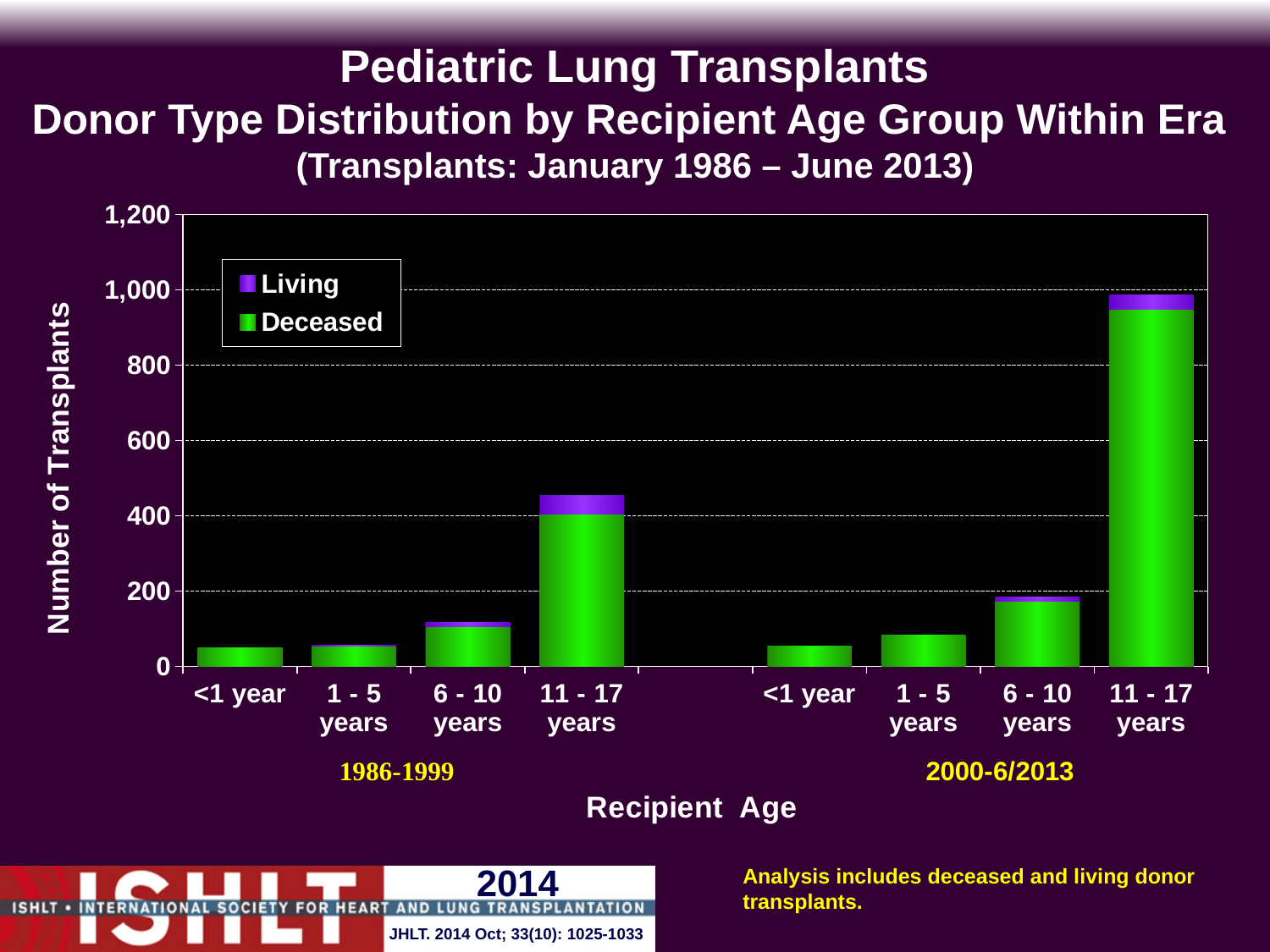
Which is larger: the total for 6 - 10 years in 1986-1999 or in 2000-6/2013? 2000-6/2013 Is the total for 11 - 17 years in the 1986-1999 era greater or less than 400? greater How many bars are plotted in the chart? 8 Which bar is the highest in the chart? 11 - 17 years, 2000-6/2013 Which is larger: the total for 11 - 17 years in 1986-1999 or in 2000-6/2013? 2000-6/2013 Within the 2000-6/2013 era, do the totals rise or fall as recipient age group increases? rise Is the total for 11 - 17 years in the 2000-6/2013 era greater or less than 800? greater How many series does the legend list? 2 Which colour represents the Living donor series in the legend? Purple What kind of chart is shown on the slide? Stacked bar chart Is the total for 6 - 10 years in the 2000-6/2013 era greater or less than 400? less